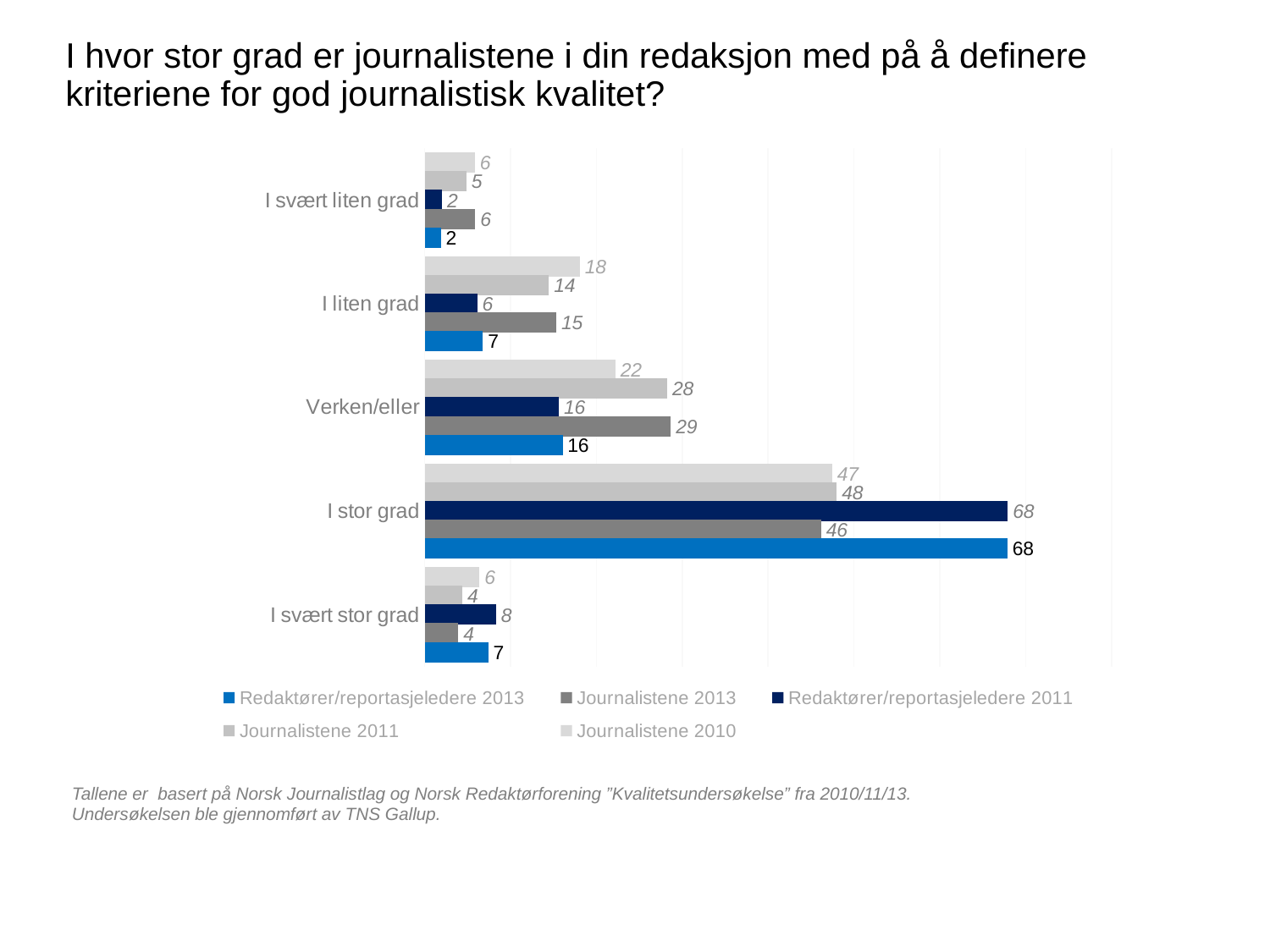
How many categories are shown on the chart? 5 Which category has the highest value for Journalistene 2011? I stor grad Which category has the lowest value for Redaktører/reportasjeledere 2013? I svært liten grad In the 'Verken/eller' category, which is larger: Journalistene 2011 or Redaktører/reportasjeledere 2011? Journalistene 2011 How many series does the legend list? 5 What is the value for Redaktører/reportasjeledere 2011 in the 'I svært stor grad' category? 8 What is the value for Journalistene 2013 in the 'Verken/eller' category? 29 Which series is shown in the darkest navy colour in the legend? Redaktører/reportasjeledere 2011 What kind of chart is shown on the slide? Bar chart What is the difference between Redaktører/reportasjeledere 2011 and Journalistene 2011 in the 'I stor grad' category? 20 What is the value for Journalistene 2010 in the 'I liten grad' category? 18 What is the value for Redaktører/reportasjeledere 2013 in the 'I stor grad' category? 68